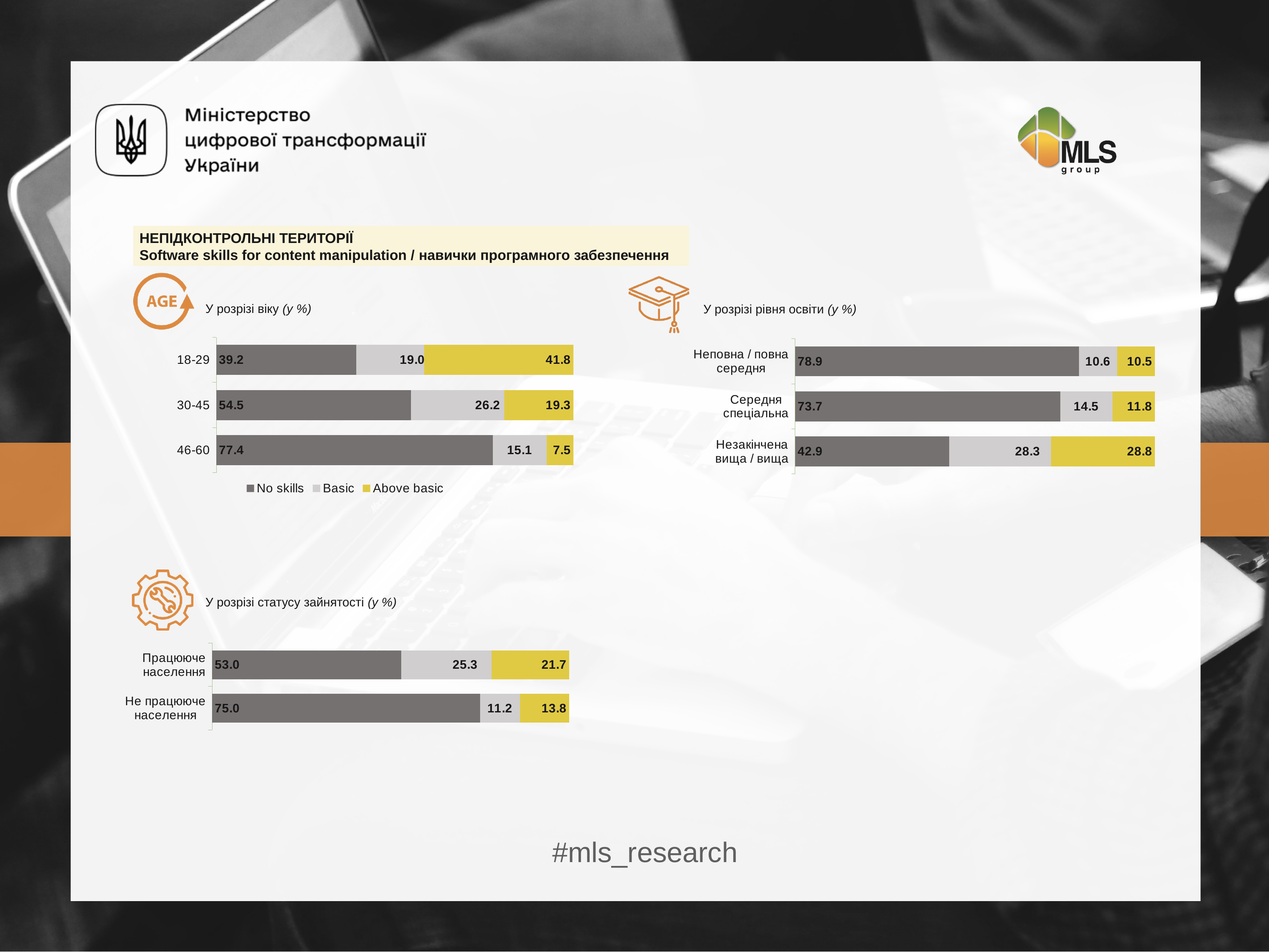
In the age chart (top left), what is the difference between the 'No skills' values for 46-60 and 18-29? 38.2 In the education chart (top right), which education level has the lowest 'No skills' value? Незакінчена вища / вища In the education chart (top right), what is the total of the stacked bar for 'Незакінчена вища / вища'? 100.0 In the age chart (top left), which age group has the highest 'Above basic' value? 18-29 In the education chart (top right), what is the 'Basic' value for 'Середня спеціальна'? 14.5 In the education chart (top right), how many education categories are shown? 3 In the employment status chart (bottom left), what is the 'Above basic' value for 'Працююче населення'? 21.7 What type of chart is the employment status chart (bottom left)? Stacked bar chart In the employment status chart (bottom left), which group has the larger 'No skills' value, 'Працююче населення' or 'Не працююче населення'? Не працююче населення In the age chart (top left), what is the 'No skills' value for the 18-29 group? 39.2 In the age chart (top left), what is the 'Above basic' value for the 46-60 group? 7.5 In the age chart (top left), how many series does the legend list? 3